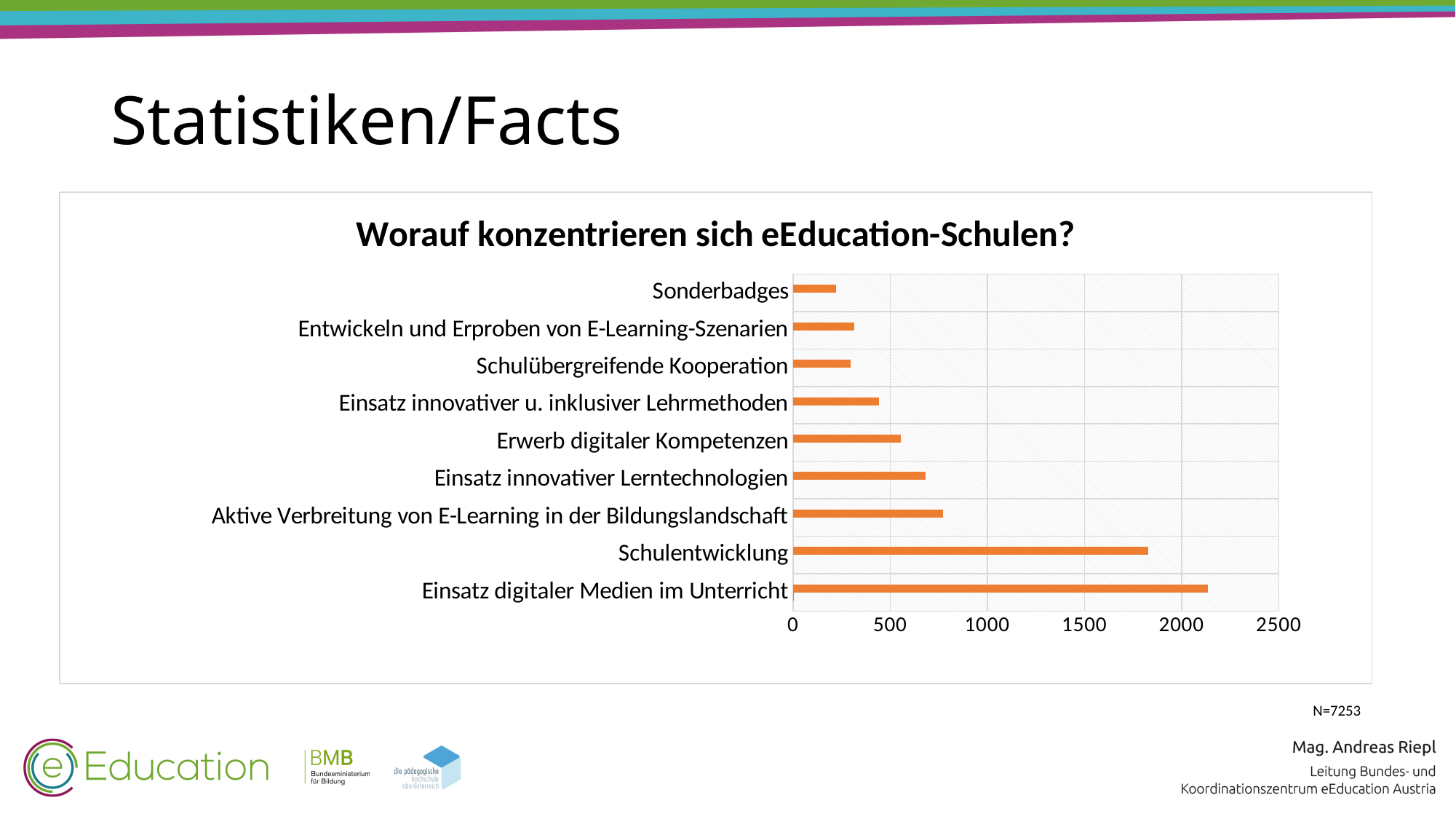
What is the title of the chart? Worauf konzentrieren sich eEducation-Schulen? Is the value for Einsatz digitaler Medien im Unterricht greater or less than 2000? greater Which category has the lowest value? Sonderbadges Which category has the highest value? Einsatz digitaler Medien im Unterricht Which is larger, the value for Einsatz innovativer Lerntechnologien or the value for Einsatz innovativer u. inklusiver Lehrmethoden? Einsatz innovativer Lerntechnologien Is the value for Erwerb digitaler Kompetenzen greater or less than 500? greater Is the value for Schulentwicklung greater or less than 1500? greater How many categories are plotted in the chart? 9 What kind of chart is shown on the slide? bar chart